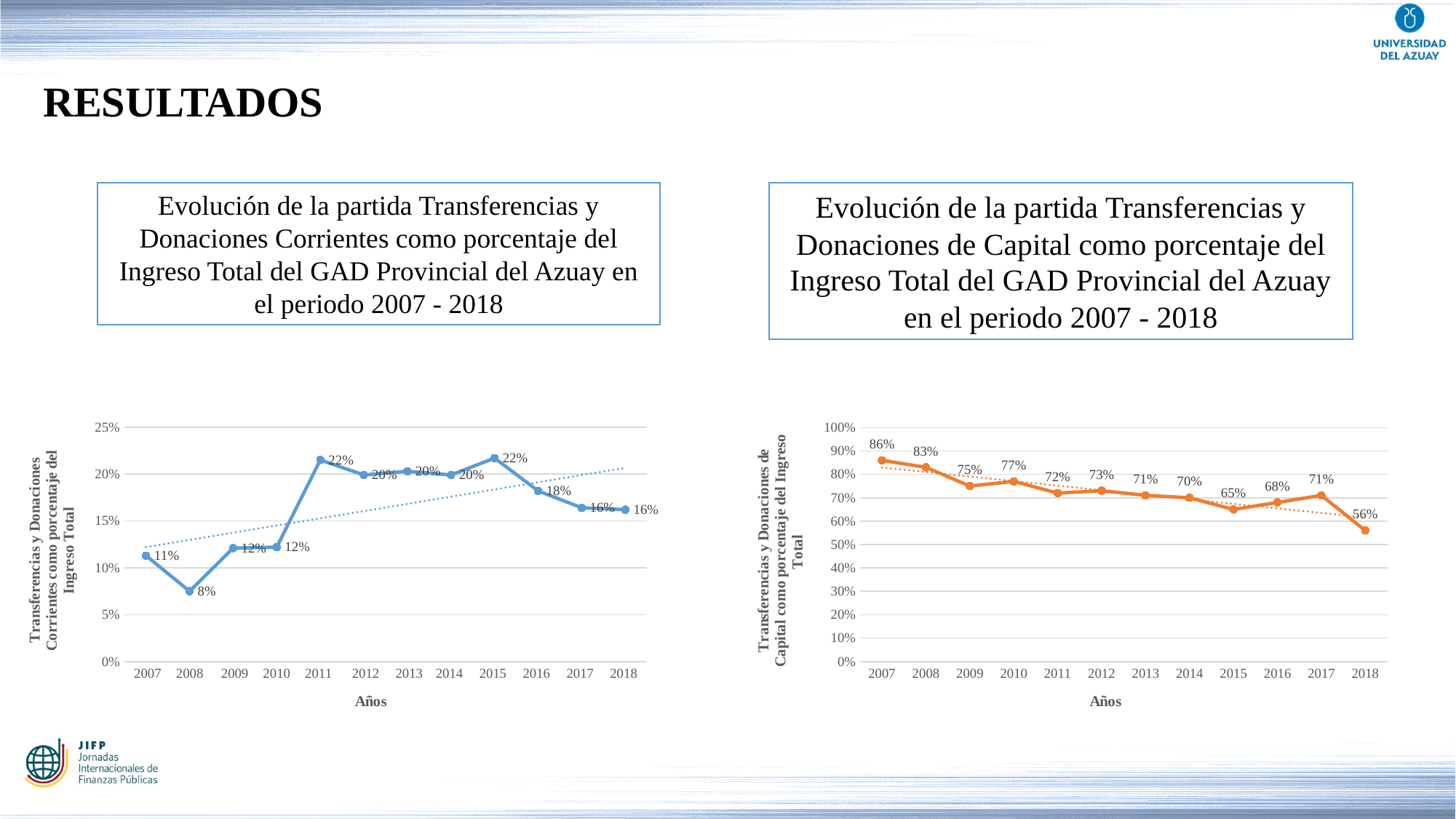
In the right chart (Transferencias y Donaciones de Capital), what is the difference between the values for 2007 and 2018? 30% In the left chart (Transferencias y Donaciones Corrientes), which year has the lowest value? 2008 In the left chart (Transferencias y Donaciones Corrientes), what is the value for 2008? 8% In the right chart (Transferencias y Donaciones de Capital), what is the value for 2007? 86% In the right chart (Transferencias y Donaciones de Capital), is the value for 2010 larger than the value for 2009? Yes In the left chart (Transferencias y Donaciones Corrientes), how many years are plotted on the x axis? 12 In the right chart (Transferencias y Donaciones de Capital), which year has the highest value? 2007 In the left chart (Transferencias y Donaciones Corrientes), what is the difference between the values for 2011 and 2018? 6% In the right chart (Transferencias y Donaciones de Capital), which year has the lowest value? 2018 What type of chart is the right chart (Transferencias y Donaciones de Capital)? Line chart In the right chart (Transferencias y Donaciones de Capital), what is the value for 2015? 65% In the left chart (Transferencias y Donaciones Corrientes), what is the value for 2016? 18%